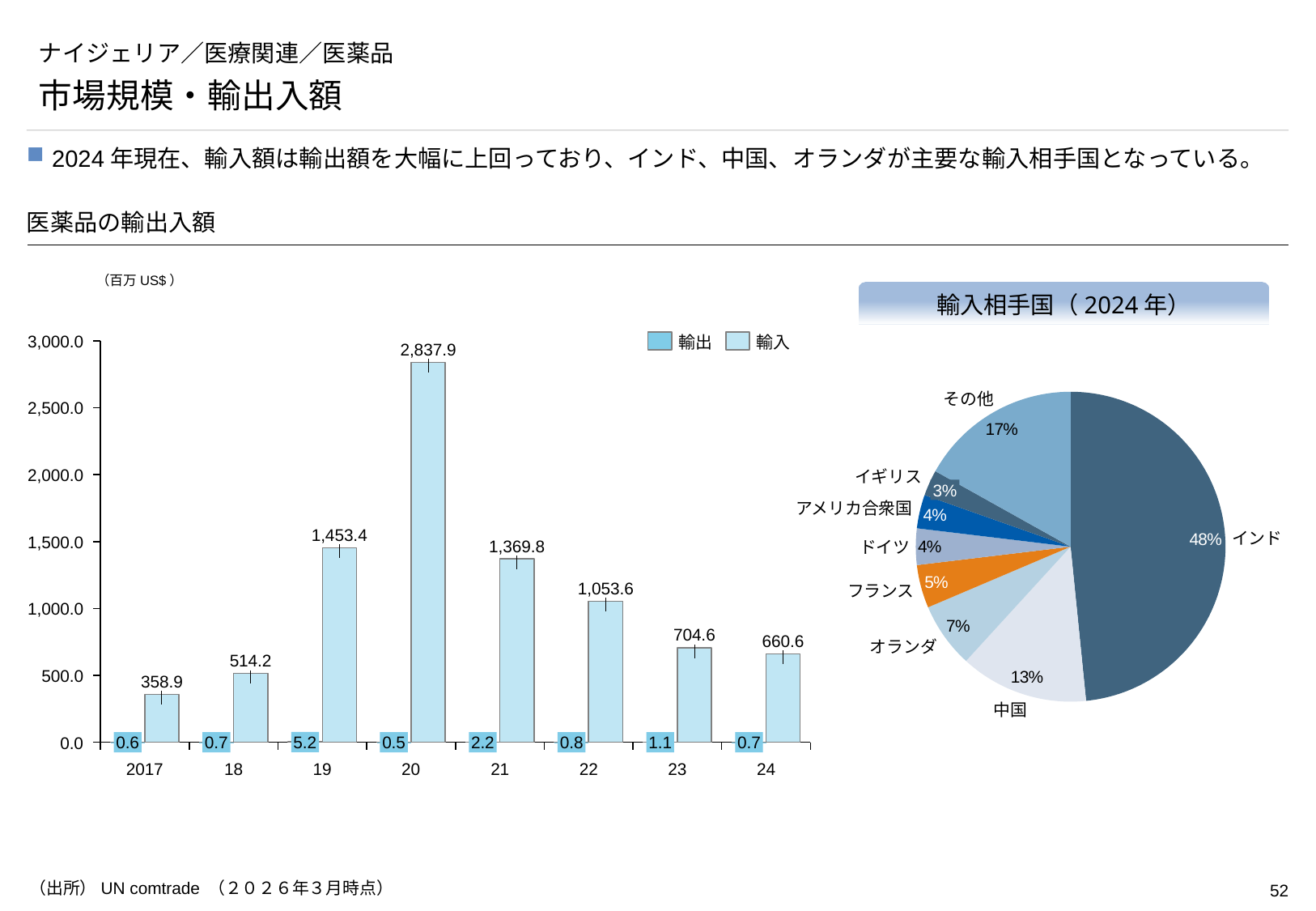
「医薬品の輸出入額」のグラフは何の種類のグラフですか？ 棒グラフ 「輸入相手国（2024年）」の円グラフで、最も割合が小さい国はどこですか？ イギリス 「医薬品の輸出入額」のグラフで、2020年から2024年にかけて輸入額は増加していますか、減少していますか？ 減少 「医薬品の輸出入額」のグラフで、2019年の輸出額はいくらですか？ 5.2 「輸入相手国（2024年）」の円グラフには、いくつの区分がありますか？ 8 「医薬品の輸出入額」のグラフで、輸入額が最も高い年はどれですか？ 20 「輸入相手国（2024年）」の円グラフで、インドの割合は何％ですか？ 48% 「医薬品の輸出入額」のグラフで、凡例にはいくつの系列がありますか？ 2 「医薬品の輸出入額」のグラフで、2020年の輸入額はいくらですか？ 2,837.9 「医薬品の輸出入額」のグラフで、輸入額が最も低い年はどれですか？ 2017 「医薬品の輸出入額」のグラフで、2023年と2024年の輸入額の差はいくらですか？ 44.0 「医薬品の輸出入額」のグラフで、2019年と2021年の輸入額ではどちらが大きいですか？ 2019年